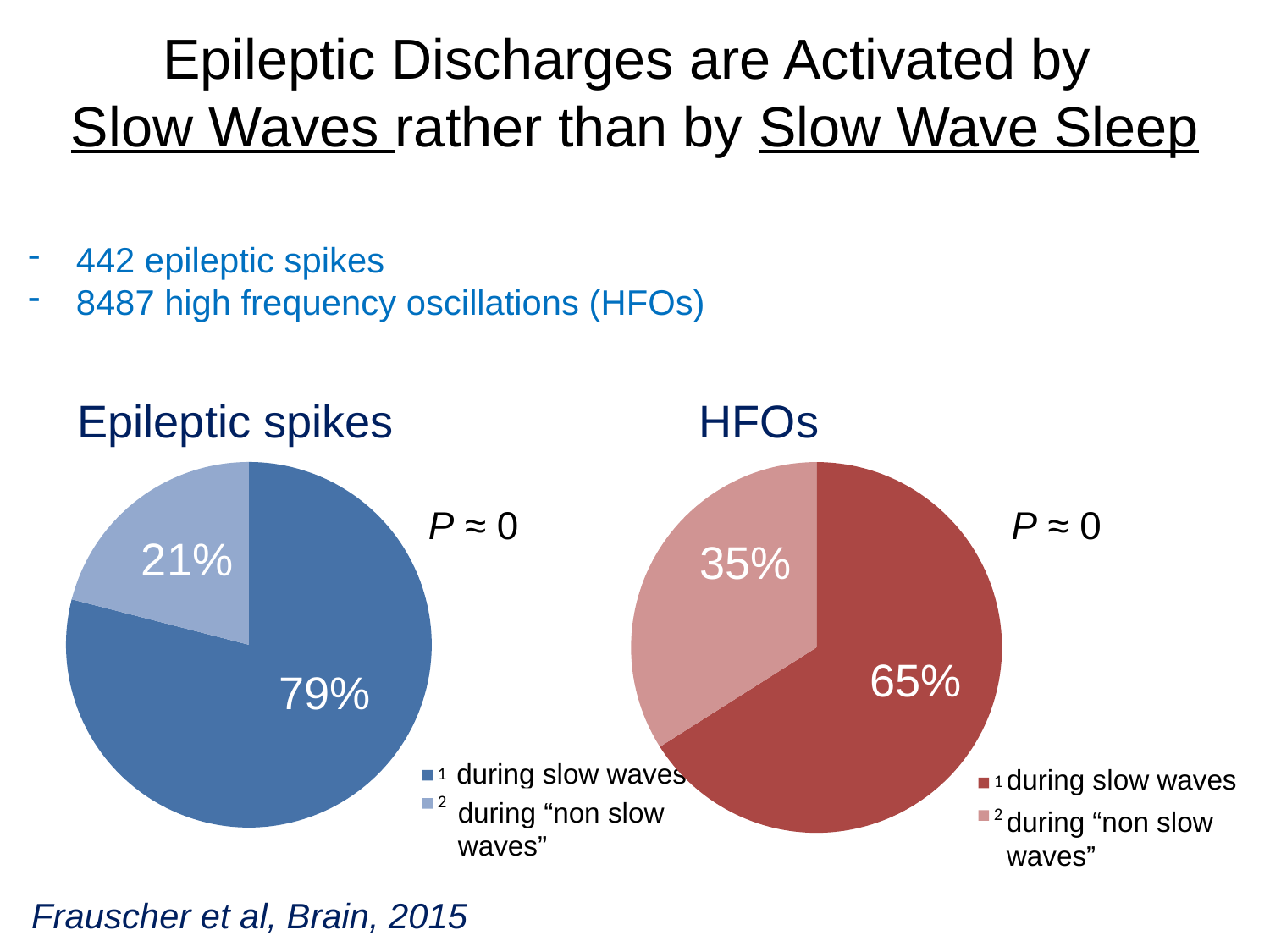
In the HFOs chart, what is the difference in percentage points between the slow waves slice and the "non slow waves" slice? 30 In the HFOs chart, which slice is the smallest? during "non slow waves" How many slices does the Epileptic spikes pie chart have? 2 In the Epileptic spikes chart, what is the difference in percentage points between the slow waves slice and the "non slow waves" slice? 58 In the Epileptic spikes chart, what percentage of spikes occurred during "non slow waves"? 21% In the Epileptic spikes chart, which slice is the largest? during slow waves In the HFOs chart, what percentage of HFOs occurred during slow waves? 65% In the Epileptic spikes chart, what percentage of spikes occurred during slow waves? 79% Which chart has the larger share for "during slow waves", the Epileptic spikes chart or the HFOs chart? Epileptic spikes How many entries does the legend of the HFOs chart list? 2 In the HFOs chart, what percentage of HFOs occurred during "non slow waves"? 35% What type of chart is the HFOs chart? pie chart